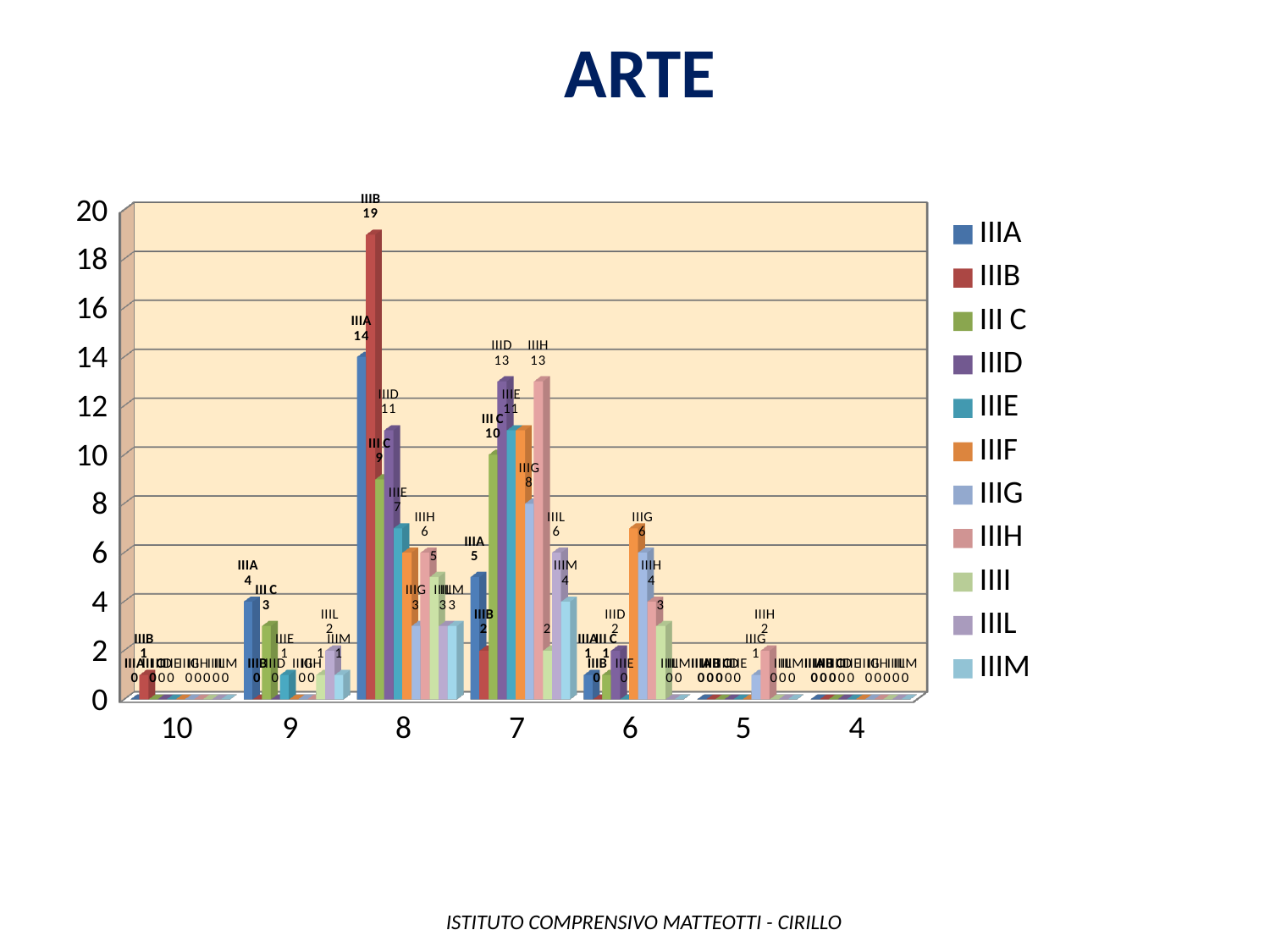
What type of chart is shown on the slide? bar chart In category 8, which is larger: the value for IIIA or the value for III C? IIIA Which series has the highest value in category 8? IIIB How many series does the legend list? 11 What is the value for IIID in category 7? 13 What is the value for IIIB in category 8? 19 What is the difference between the IIIB and IIIA values in category 8? 5 What is the value for IIIA in category 8? 14 What is the title of the chart? ARTE How many categories are shown on the x axis? 7 What is the value for IIIA in category 9? 4 What is the value for IIIG in category 7? 8